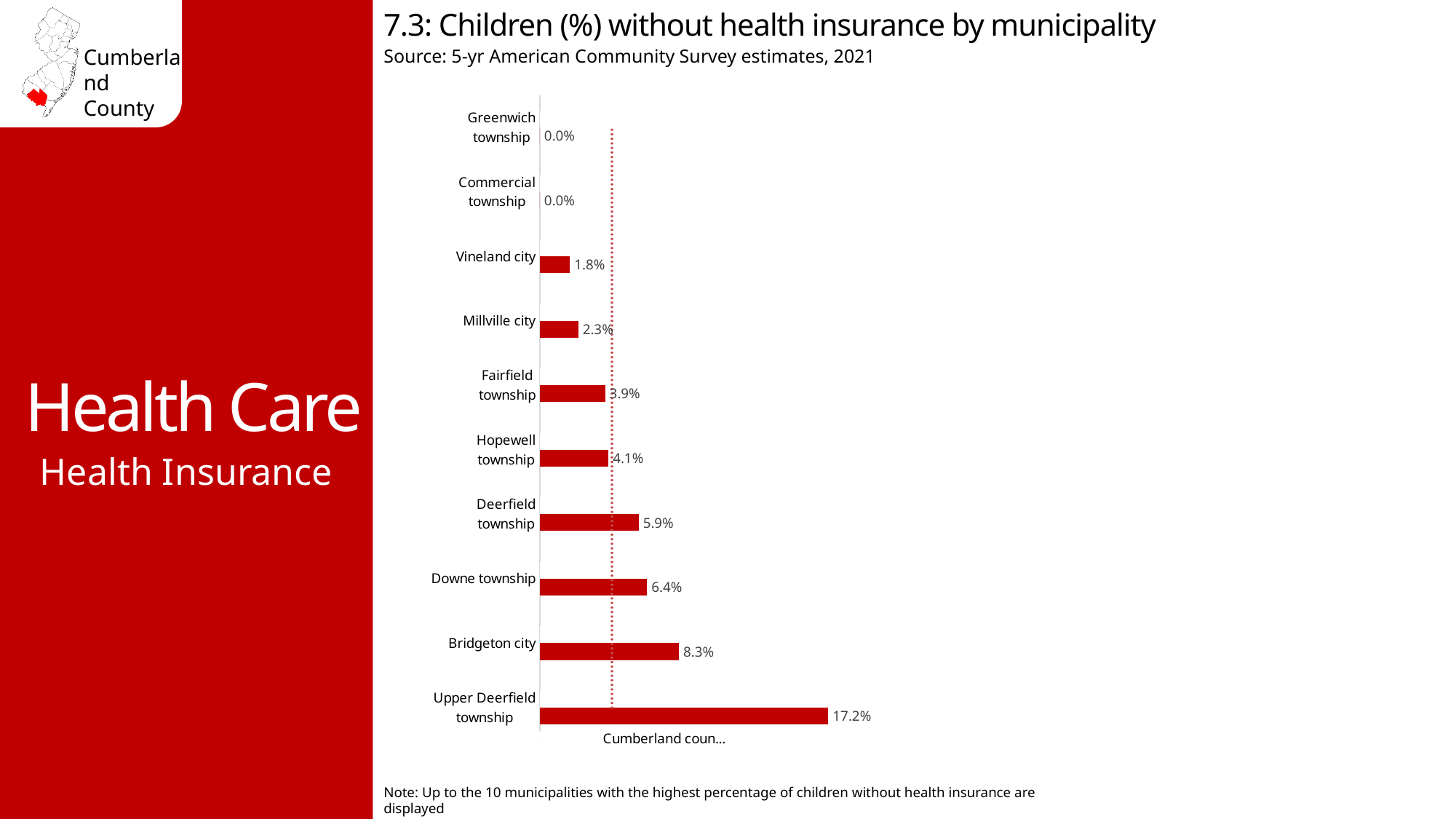
What percentage is shown for Vineland city? 1.8% How many municipalities are shown in the chart? 10 What is the difference between the values for Upper Deerfield township and Bridgeton city? 8.9% Which has a higher value, Millville city or Fairfield township? Fairfield township What is the difference between Downe township and Deerfield township? 0.5% What is the value shown for Bridgeton city? 8.3% Which municipalities show a value of 0.0%? Greenwich township and Commercial township What is the title of the chart? 7.3: Children (%) without health insurance by municipality Which municipality has the highest percentage of children without health insurance? Upper Deerfield township What is the value for Hopewell township? 4.1% What type of chart is shown on the slide? Bar chart What percentage of children are without health insurance in Upper Deerfield township? 17.2%